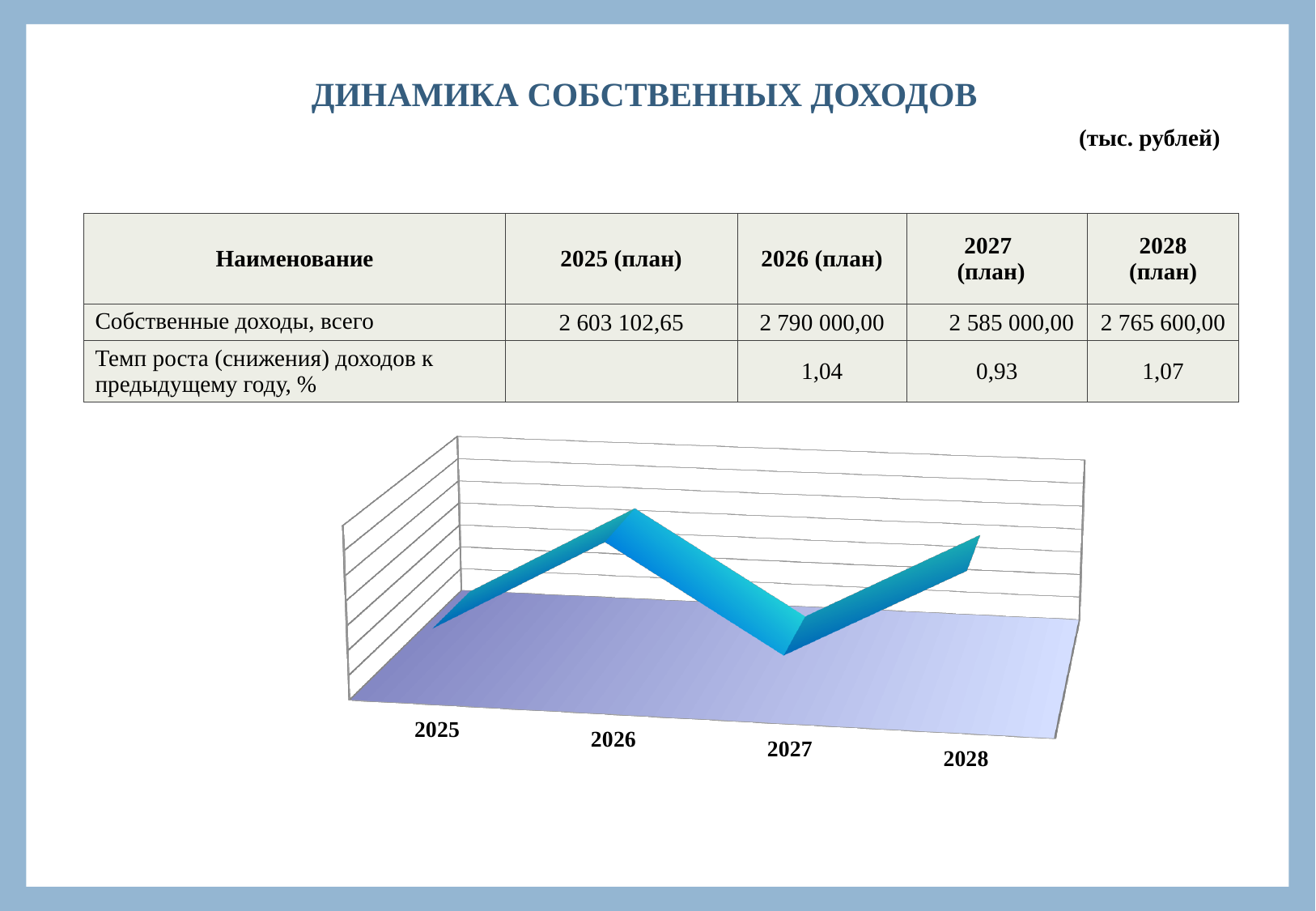
Which is larger, the value for 2026 or the value for 2028? 2026 What is the difference between the values for 2026 and 2027? 205 000,00 Which year has the highest value in the chart? 2026 In what units are the values given, according to the slide? тыс. рублей What is the planned value of 'Собственные доходы, всего' for 2026? 2 790 000,00 What is the planned value of 'Собственные доходы, всего' for 2027? 2 585 000,00 How many years are plotted along the x axis of the chart? 4 What is the title of the slide above the chart? ДИНАМИКА СОБСТВЕННЫХ ДОХОДОВ Does the line rise or fall from 2026 to 2027? fall What kind of chart is shown on the slide? line chart What is the planned value of 'Собственные доходы, всего' for 2028? 2 765 600,00 What is the growth rate ('Темп роста') for 2027 compared to the previous year? 0,93